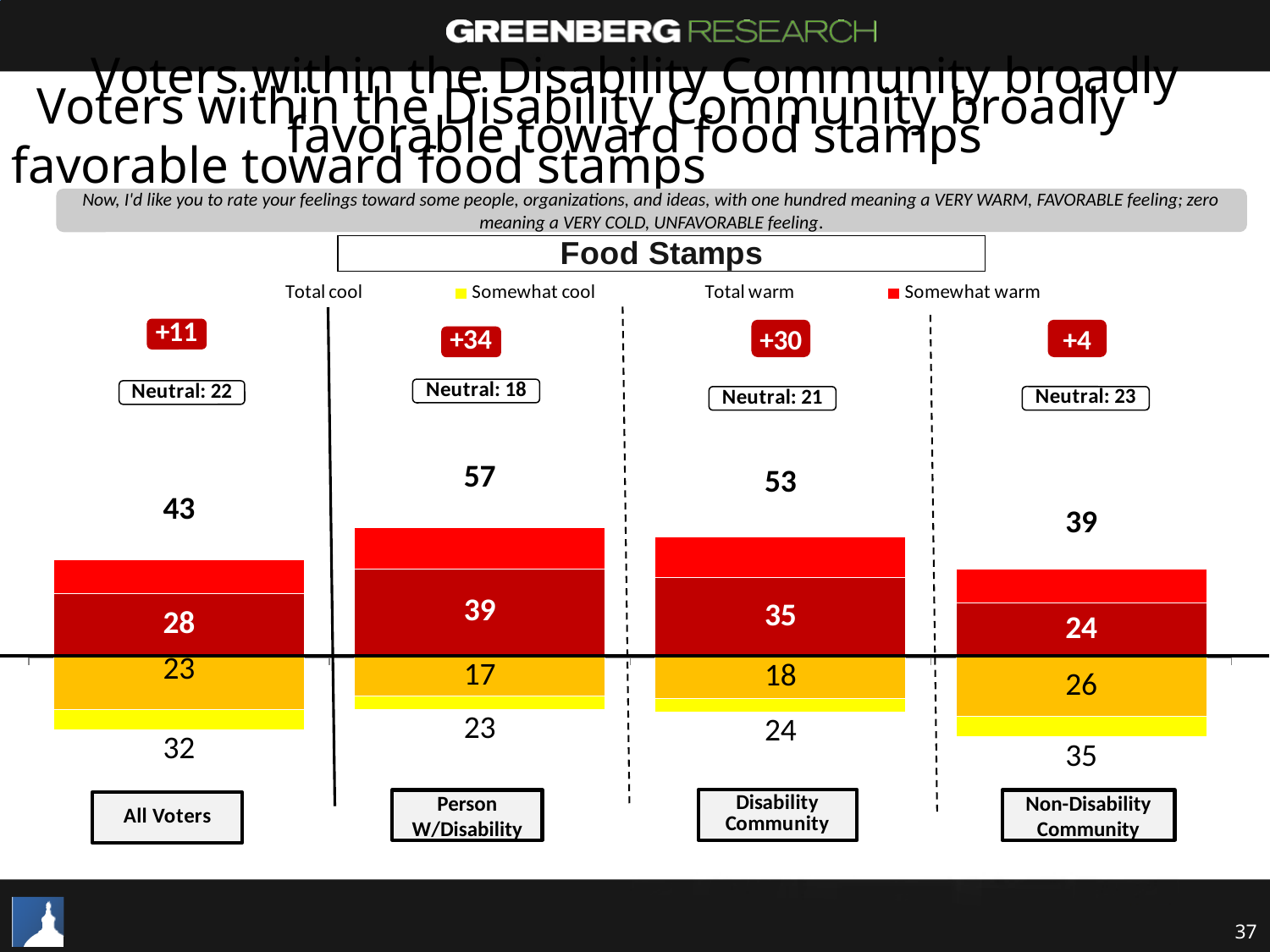
Which group has the highest Total warm value in the Food Stamps chart? Person W/Disability Which is larger in the Food Stamps chart: the Total cool value for All Voters or for Disability Community? All Voters What is the difference between the Total warm values for Person W/Disability and All Voters in the Food Stamps chart? 14 What net score is shown above the Disability Community bar in the Food Stamps chart? +30 What is the Total warm value for the Disability Community in the Food Stamps chart? 53 What kind of chart is the Food Stamps chart? Stacked bar chart Which group has the lowest Total warm value in the Food Stamps chart? Non-Disability Community What is the Total cool value for Non-Disability Community in the Food Stamps chart? 35 How many series does the legend of the Food Stamps chart list? 4 How many groups are shown along the x axis of the Food Stamps chart? 4